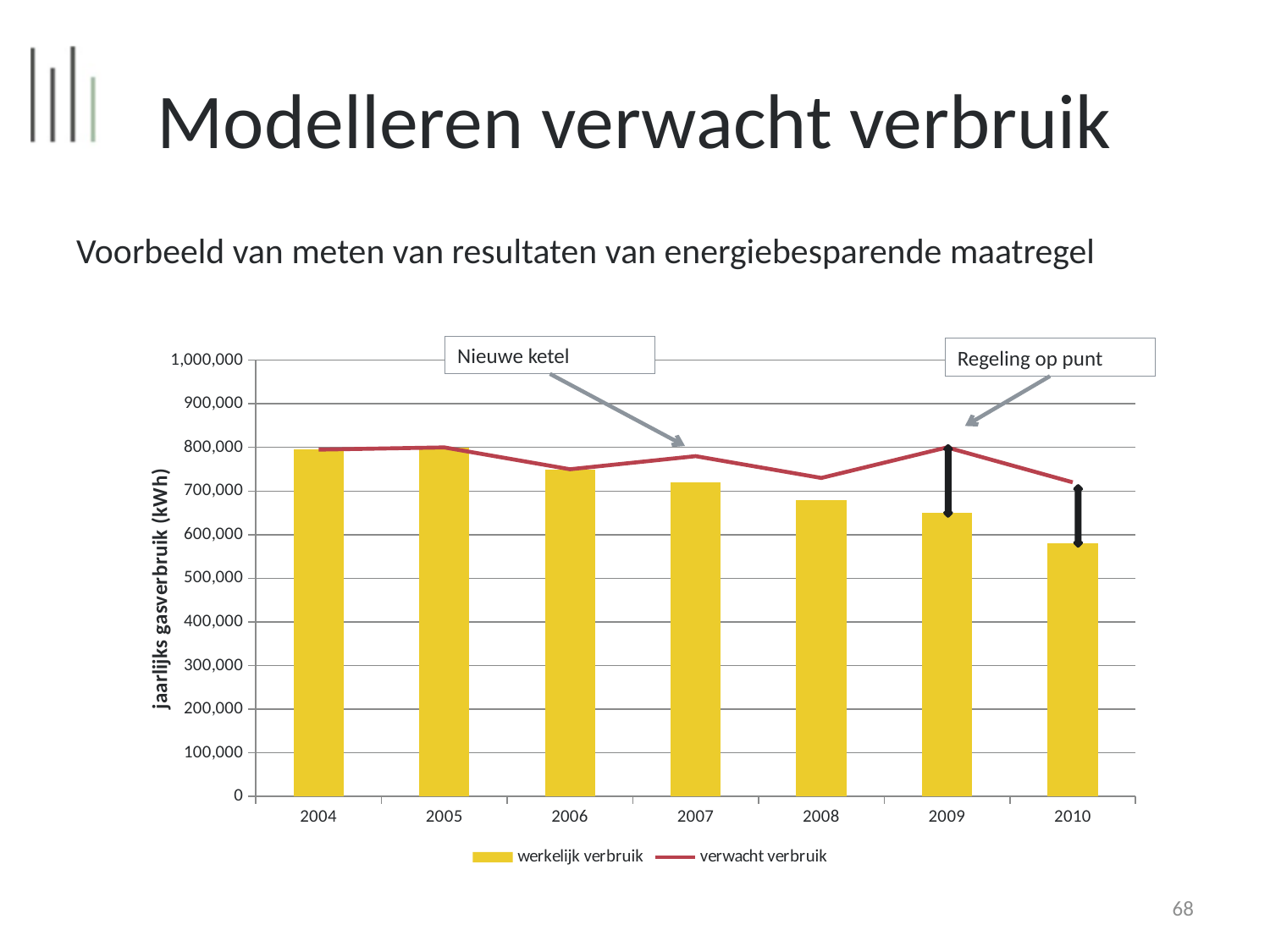
How many years are shown on the x axis of the chart? 7 What is the title of the vertical axis of the chart? jaarlijks gasverbruik (kWh) Which year has the lowest bar for werkelijk verbruik? 2010 What are the two entries in the chart legend? werkelijk verbruik and verwacht verbruik Is the werkelijk verbruik bar for 2010 greater or less than 600,000? less Is the werkelijk verbruik bar for 2009 greater or less than 600,000? greater Which is larger, the werkelijk verbruik bar for 2006 or for 2008? 2006 Is the werkelijk verbruik bar for 2008 greater or less than 700,000? less Do the werkelijk verbruik bars rise or fall from 2004 to 2010? fall How many series does the chart legend list? 2 Which is larger, the werkelijk verbruik bar for 2007 or for 2010? 2007